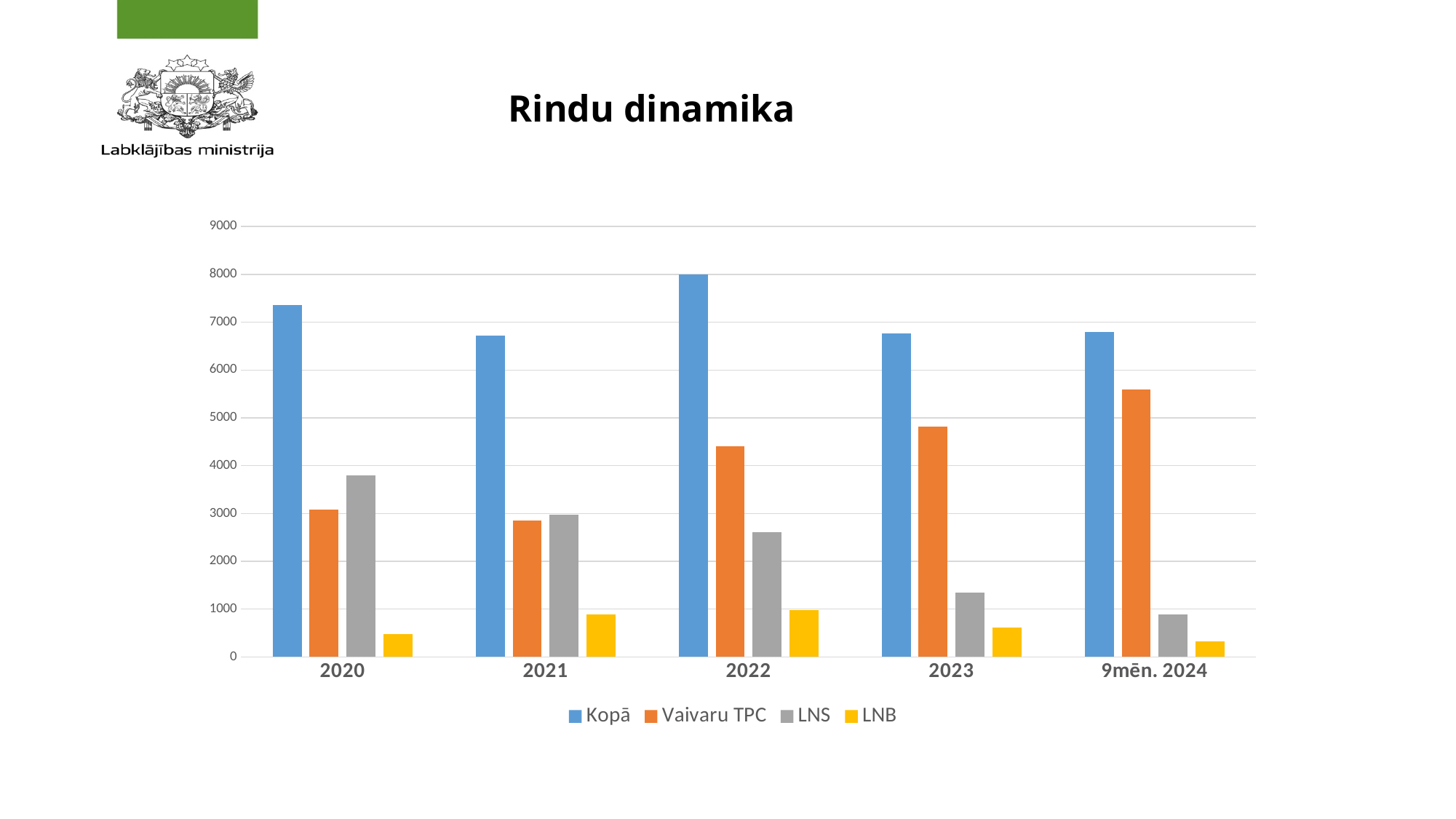
What kind of chart is shown on the slide? bar chart Is the Kopā value for 2020 greater or less than 7000? greater In 2020, which is larger: the LNS value or the Vaivaru TPC value? LNS How many categories are shown on the x axis? 5 How many series does the legend list? 4 Do the LNS values rise or fall from 2020 to 9mēn. 2024? fall In which category is the Kopā value highest? 2022 In which category is the Vaivaru TPC value highest? 9mēn. 2024 Is the Vaivaru TPC value for 2022 greater or less than 4000? greater In which category is the LNS value lowest? 9mēn. 2024 In which category is the LNB value lowest? 9mēn. 2024 Is the LNS value for 2023 greater or less than 2000? less